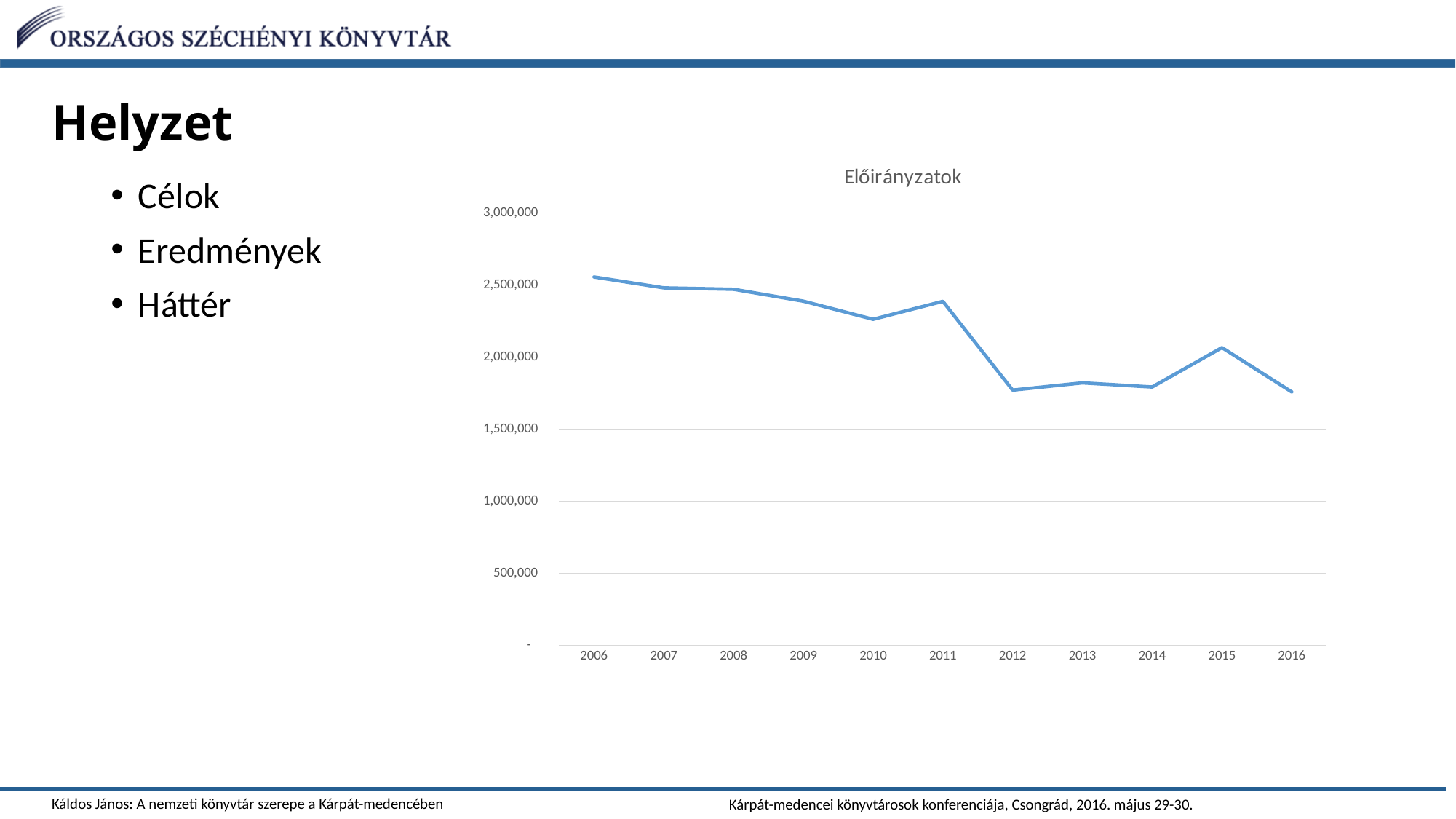
Which is larger, the value for 2014 or the value for 2015? 2015 Is the value for 2015 greater or less than 2,000,000? greater What is the title of the chart? Előirányzatok Which is larger, the value for 2006 or the value for 2016? 2006 Which year has the highest value in the chart? 2006 Which is larger, the value for 2011 or the value for 2012? 2011 Is the value for 2012 greater or less than 2,000,000? less Is the value for 2010 greater or less than 2,500,000? less What kind of chart is shown on the slide? line chart How many years are plotted on the x axis of the chart? 11 Do the values in the chart generally rise or fall from 2006 to 2016? fall